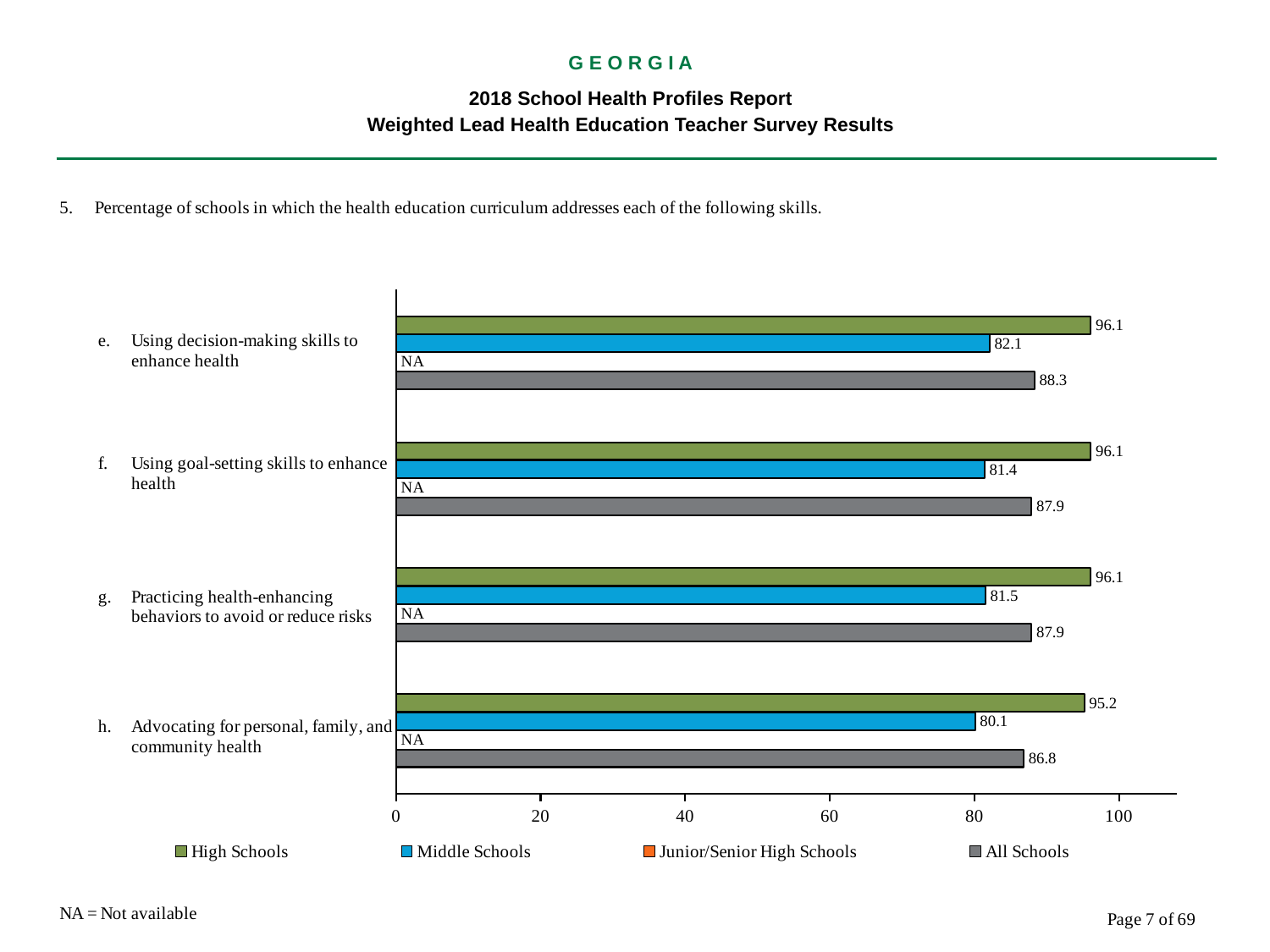
What is the difference between the High Schools and Middle Schools values for "Using decision-making skills to enhance health"? 14.0 What is the Middle Schools value for "Advocating for personal, family, and community health"? 80.1 What is the Junior/Senior High Schools value for "Practicing health-enhancing behaviors to avoid or reduce risks"? NA Which is larger for "Practicing health-enhancing behaviors to avoid or reduce risks": the Middle Schools value or the All Schools value? All Schools What is the High Schools value for "Using decision-making skills to enhance health"? 96.1 Which category has the lowest Middle Schools value? Advocating for personal, family, and community health What kind of chart is shown on the slide? bar chart How many skill categories are shown on the chart? 4 How many series does the legend list? 4 What is the All Schools value for "Using goal-setting skills to enhance health"? 87.9 Which category has the lowest High Schools value? Advocating for personal, family, and community health Is the Middle Schools value for "Using goal-setting skills to enhance health" greater or less than 80? greater